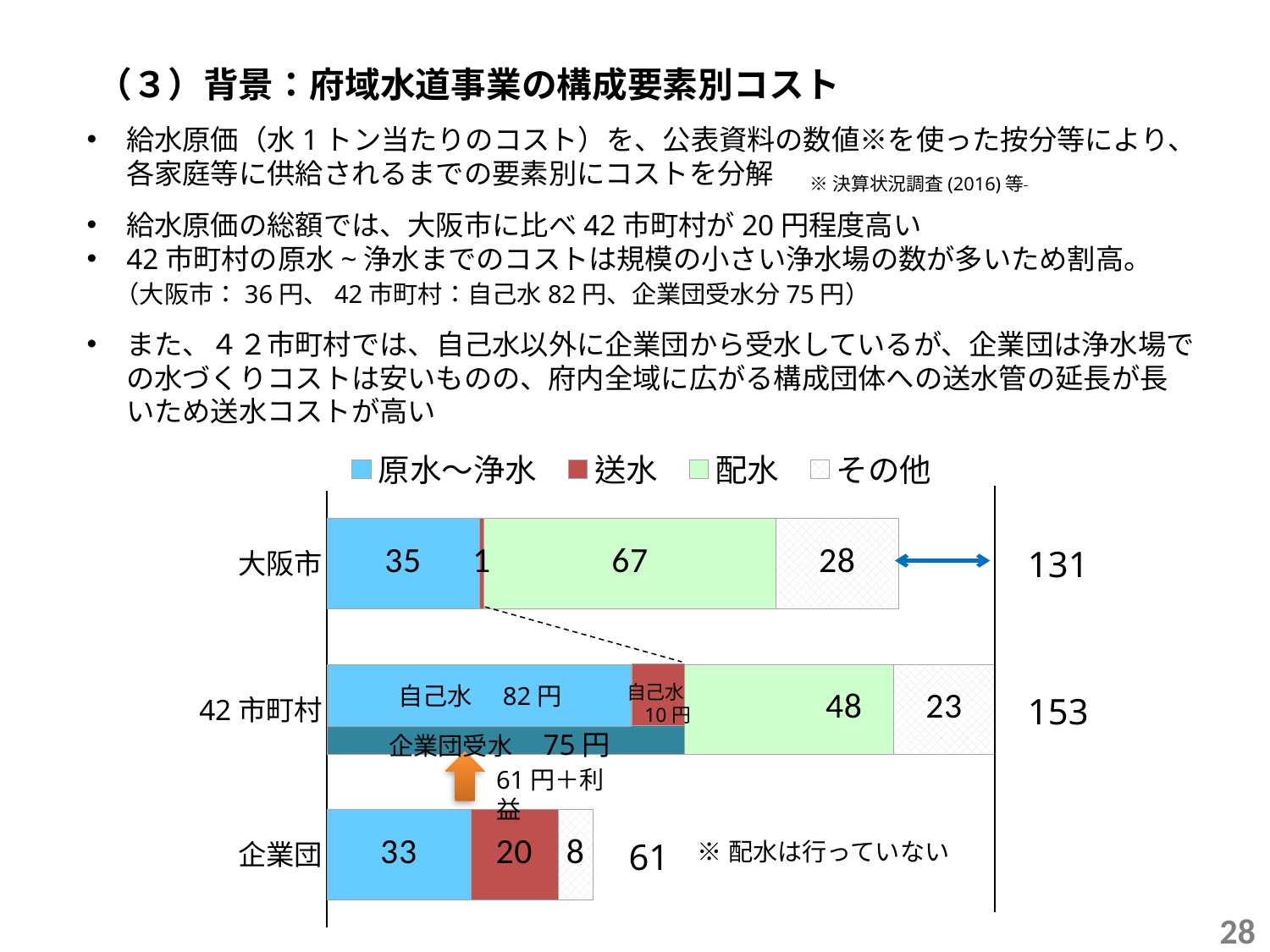
What is the 送水 value for 企業団? 20 What is the その他 value for 42市町村? 23 How many categories (bars) are plotted in the chart? 3 What is the 配水 value for 大阪市? 67 What is the total shown for the 42市町村 bar? 153 What is the 原水～浄水 value for 企業団? 33 What kind of chart is shown on the slide? bar chart Which category has the highest total? 42市町村 What is the total shown for the 大阪市 bar? 131 What is the difference between the 配水 values of 大阪市 and 42市町村? 19 How many series does the legend list? 4 Which category has the lowest total? 企業団